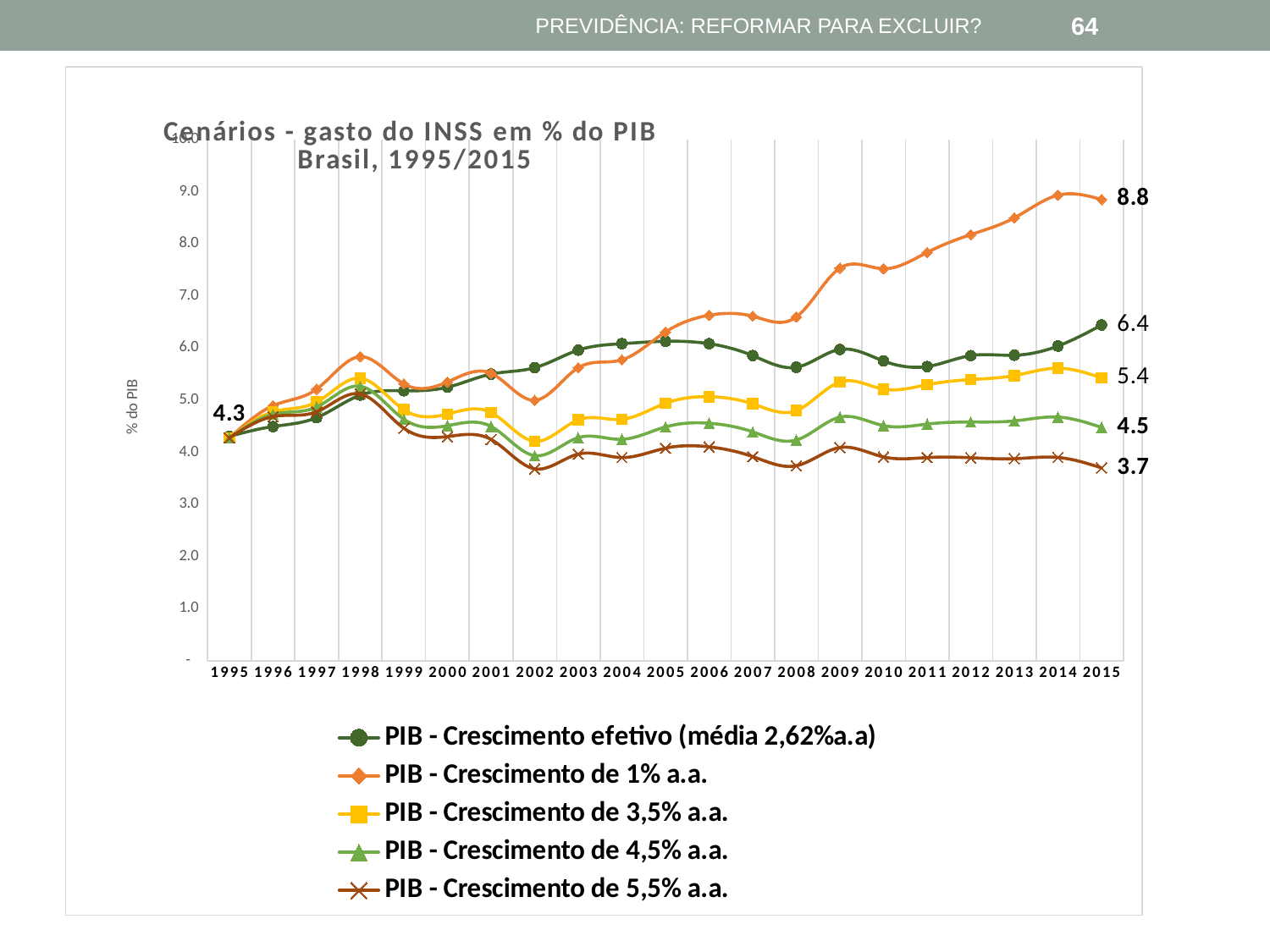
What is the difference between the 2015 values of the 'PIB - Crescimento de 1% a.a.' series and the 'PIB - Crescimento de 5,5% a.a.' series? 5.1 How many series does the legend list? 5 How many years are plotted along the x axis? 21 Which series has the highest value in 2015? PIB - Crescimento de 1% a.a. What is the value of the 'PIB - Crescimento de 5,5% a.a.' series in 2015? 3.7 What is the value of the 'PIB - Crescimento de 3,5% a.a.' series in 2015? 5.4 Is the value of the 'PIB - Crescimento de 1% a.a.' series in 2009 greater or less than 7.0? greater What is the value of the 'PIB - Crescimento efetivo (média 2,62%a.a)' series in 2015? 6.4 What is the starting value of the series in 1995? 4.3 What is the value of the 'PIB - Crescimento de 1% a.a.' series in 2015? 8.8 What kind of chart is shown on the slide? line chart Which series has the lowest value in 2015? PIB - Crescimento de 5,5% a.a.